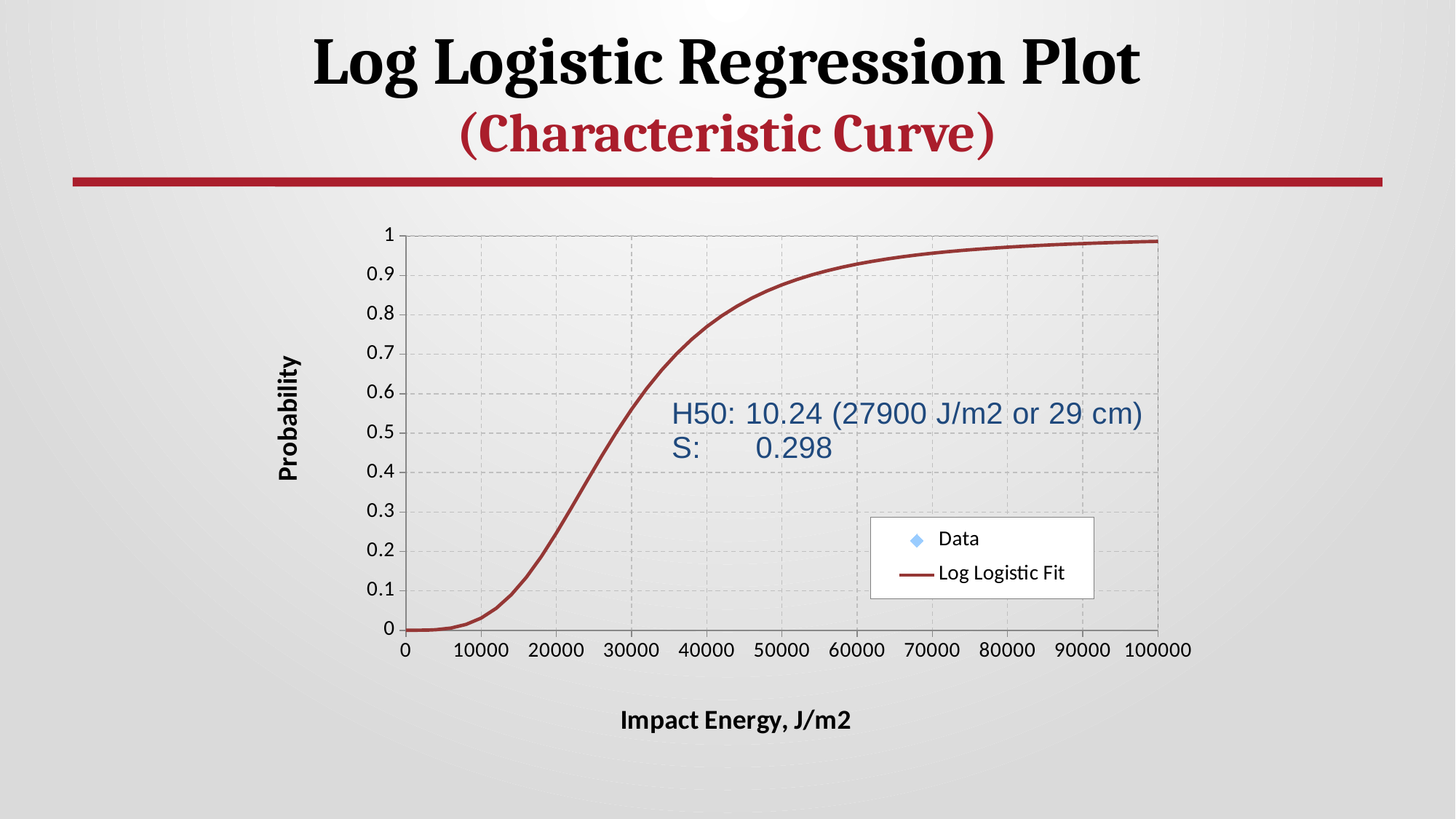
What S value is printed in the annotation on the chart? 0.298 What kind of chart is shown on the slide? line chart Is the probability of the Log Logistic Fit at 30000 J/m2 greater or less than 0.5? greater Is the probability of the Log Logistic Fit at 10000 J/m2 greater or less than 0.1? less Is the probability of the Log Logistic Fit at 50000 J/m2 greater or less than 0.8? greater Does the Log Logistic Fit curve rise or fall as Impact Energy increases along the x axis? rise What are the two entries in the chart legend? Data and Log Logistic Fit What is the maximum value shown on the x axis? 100000 How many series does the legend list? 2 What is the label of the x axis? Impact Energy, J/m2